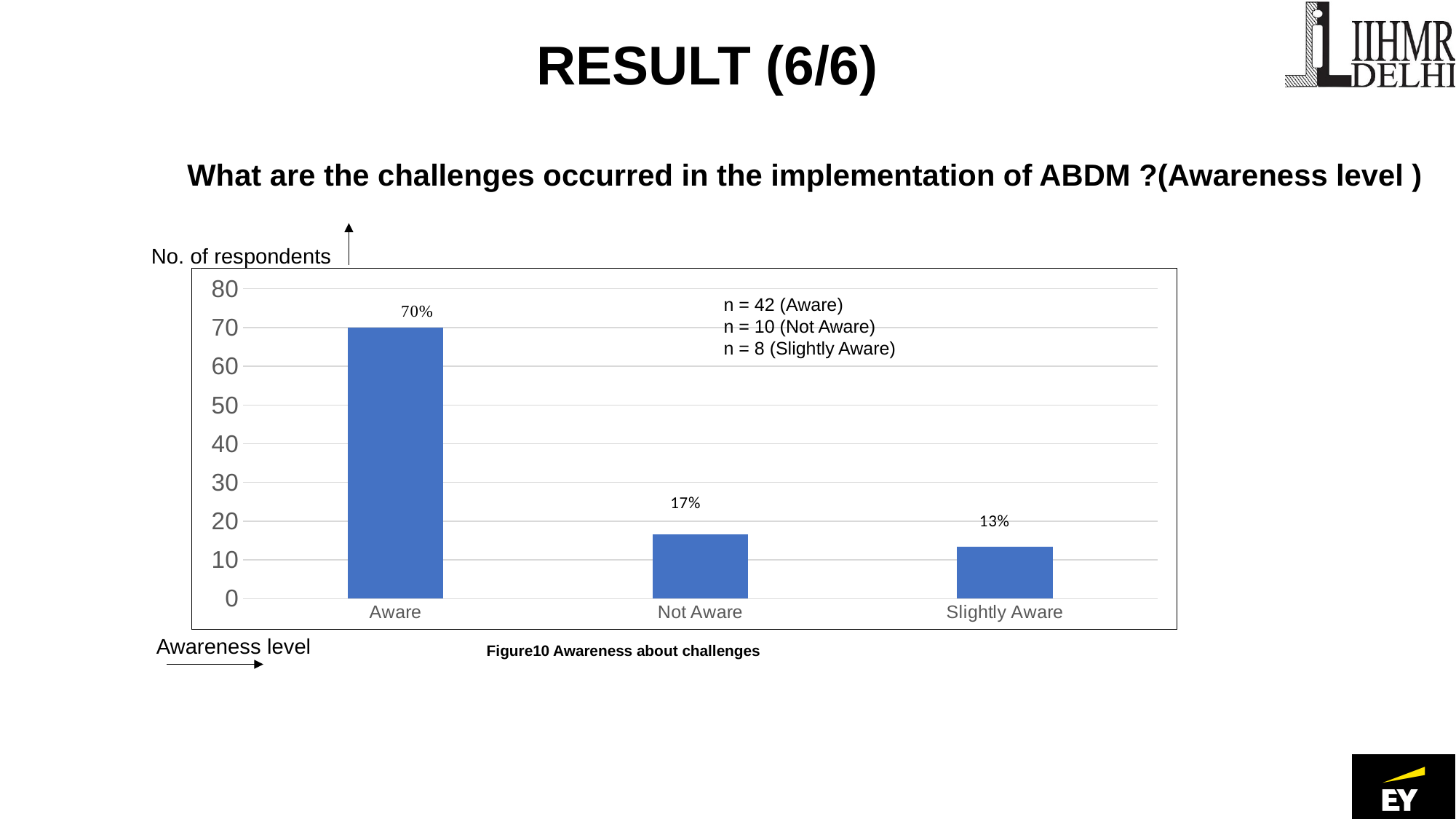
Which is larger, the bar for Not Aware or the bar for Slightly Aware? Not Aware What data label is shown on the bar for Aware? 70% Which awareness level has the highest bar? Aware What data label is shown on the bar for Not Aware? 17% Is the value for Not Aware greater or less than 20 on the y axis? less Is the value for Aware greater or less than 60 on the y axis? greater What kind of chart is shown on the slide? Bar chart What is the figure caption printed below the chart? Figure10 Awareness about challenges Which awareness level has the lowest bar? Slightly Aware What data label is shown on the bar for Slightly Aware? 13% What is the difference between the data labels for Aware and Not Aware? 53 percentage points How many awareness level categories are shown on the x axis? 3